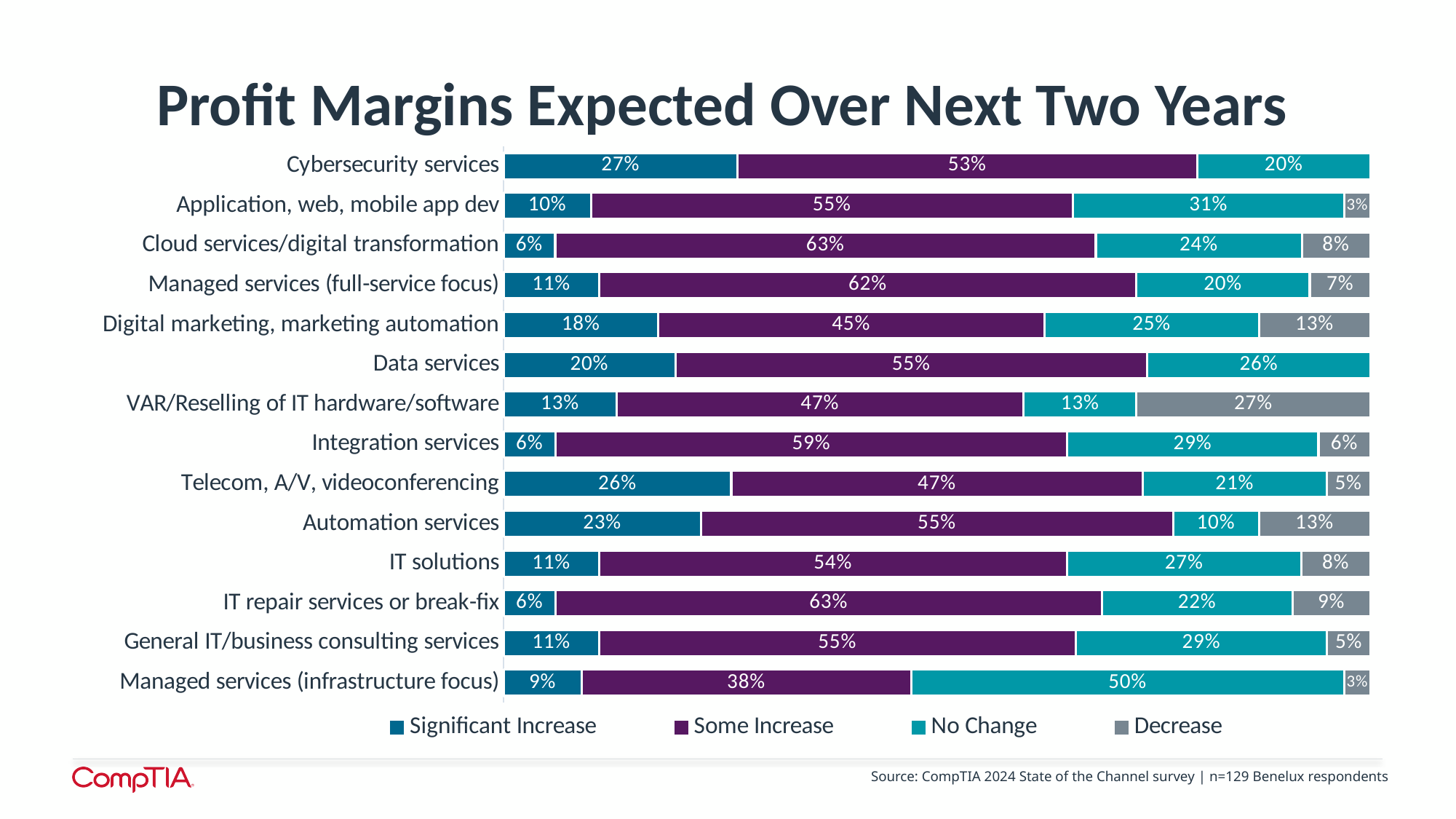
For Cloud services/digital transformation, how much larger is the Some Increase value than the Significant Increase value? 57 percentage points How many categories are shown in the chart? 14 What percentage of respondents expect a Significant Increase in profit margins for Cybersecurity services? 27% What is the title of the chart? Profit Margins Expected Over Next Two Years What kind of chart is shown on the slide? Stacked bar chart How many series does the legend list? 4 Which has a larger Significant Increase value: Automation services or Data services? Automation services Which category has the lowest Some Increase value? Managed services (infrastructure focus) What is the No Change value for Managed services (infrastructure focus)? 50% Which category has the highest Decrease value? VAR/Reselling of IT hardware/software What is the Decrease value for VAR/Reselling of IT hardware/software? 27% Which category has the highest Significant Increase value? Cybersecurity services